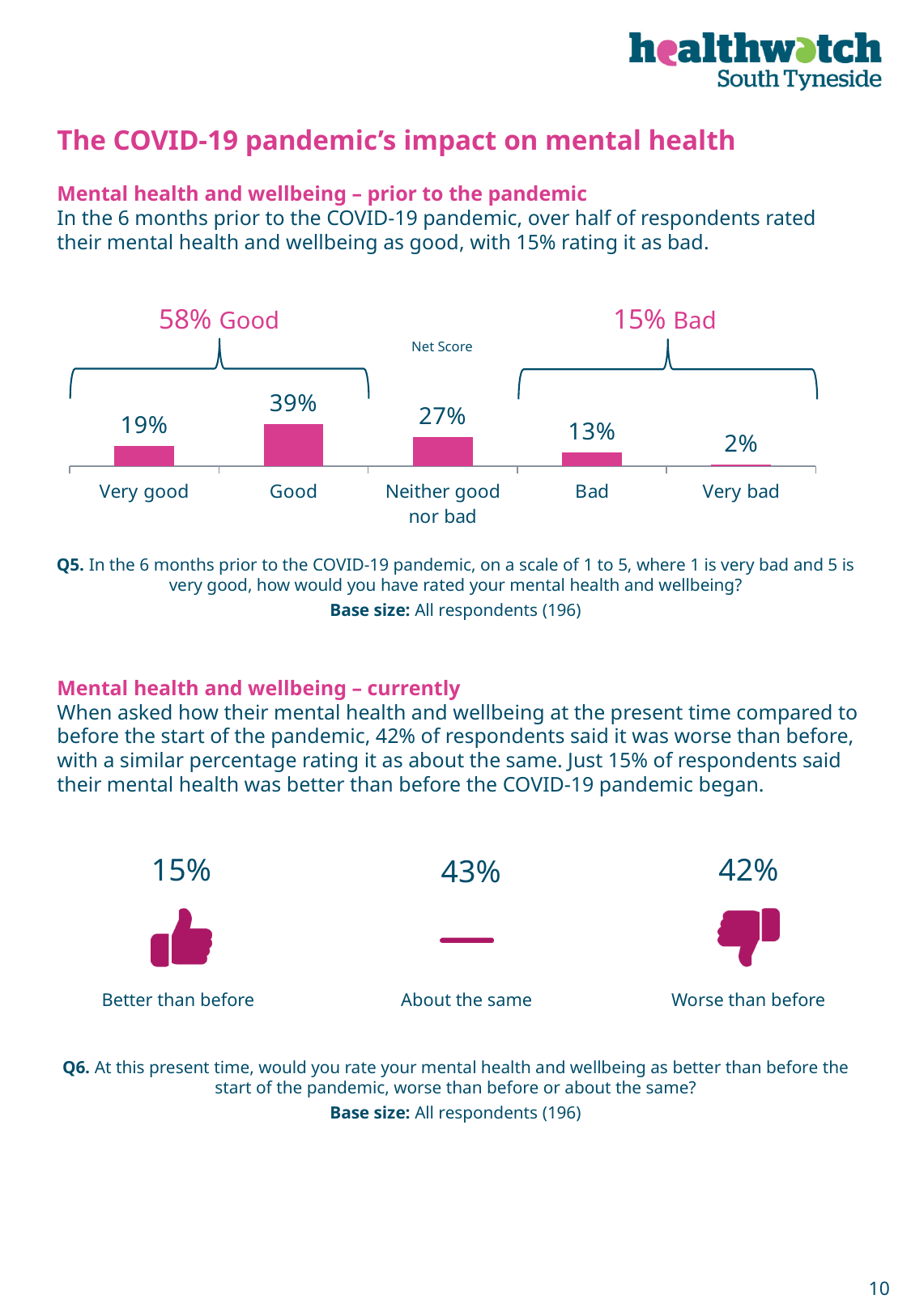
In the bar chart on mental health prior to the pandemic, what percentage of respondents rated their mental health as Good? 39% What type of chart is used to show mental health and wellbeing prior to the pandemic? Bar chart In the bar chart on mental health prior to the pandemic, which category has the highest value? Good In the lower graphic on current mental health and wellbeing, what is the difference between Worse than before and Better than before? 27% In the lower graphic on current mental health and wellbeing, what percentage of respondents said About the same? 43% In the bar chart on mental health prior to the pandemic, what percentage of respondents rated their mental health as Very bad? 2% In the bar chart on mental health prior to the pandemic, which is larger: Very good or Bad? Very good In the bar chart on mental health prior to the pandemic, which category has the lowest value? Very bad In the bar chart on mental health prior to the pandemic, what is the net score labelled as Good? 58% Good In the bar chart on mental health prior to the pandemic, what is the value for Neither good nor bad? 27% How many categories are shown in the bar chart on mental health prior to the pandemic? 5 In the bar chart on mental health prior to the pandemic, what is the difference between the Good and Very good percentages? 20%